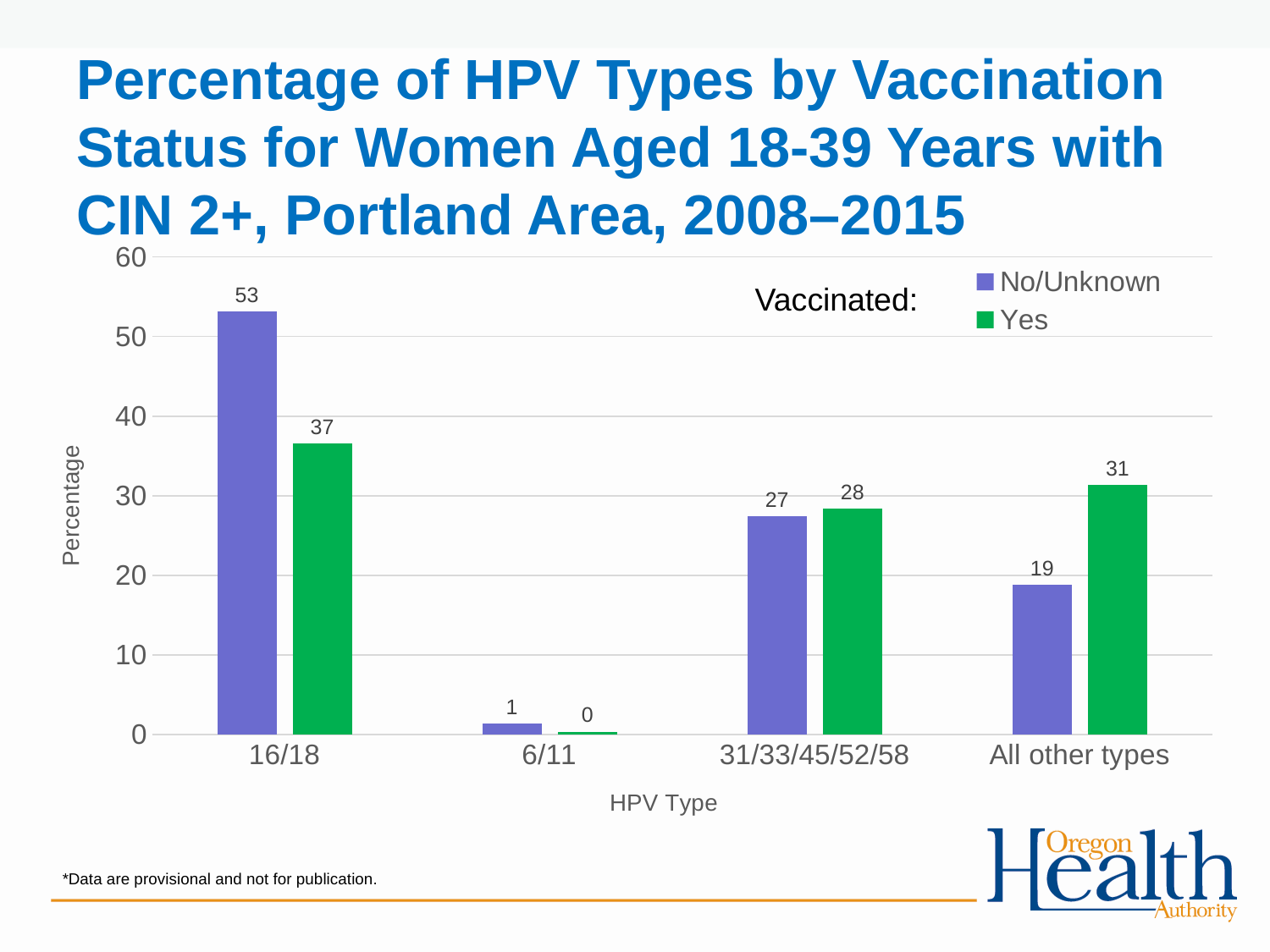
How many HPV type categories are shown on the x axis? 4 What is the value for No/Unknown vaccinated women for HPV type 16/18? 53 Which HPV type has the highest value for the No/Unknown series? 16/18 What is the value for No/Unknown vaccinated women for HPV type 6/11? 1 How many series does the legend list? 2 What kind of chart is shown on the slide? Bar chart For All other types, which is larger: the No/Unknown value or the Yes value? Yes What is the label of the y axis? Percentage What is the value for Yes (vaccinated) women for HPV type 16/18? 37 What is the value for Yes (vaccinated) women for All other types? 31 Which HPV type has the lowest value for the Yes series? 6/11 What is the difference between the No/Unknown and Yes values for HPV type 16/18? 16